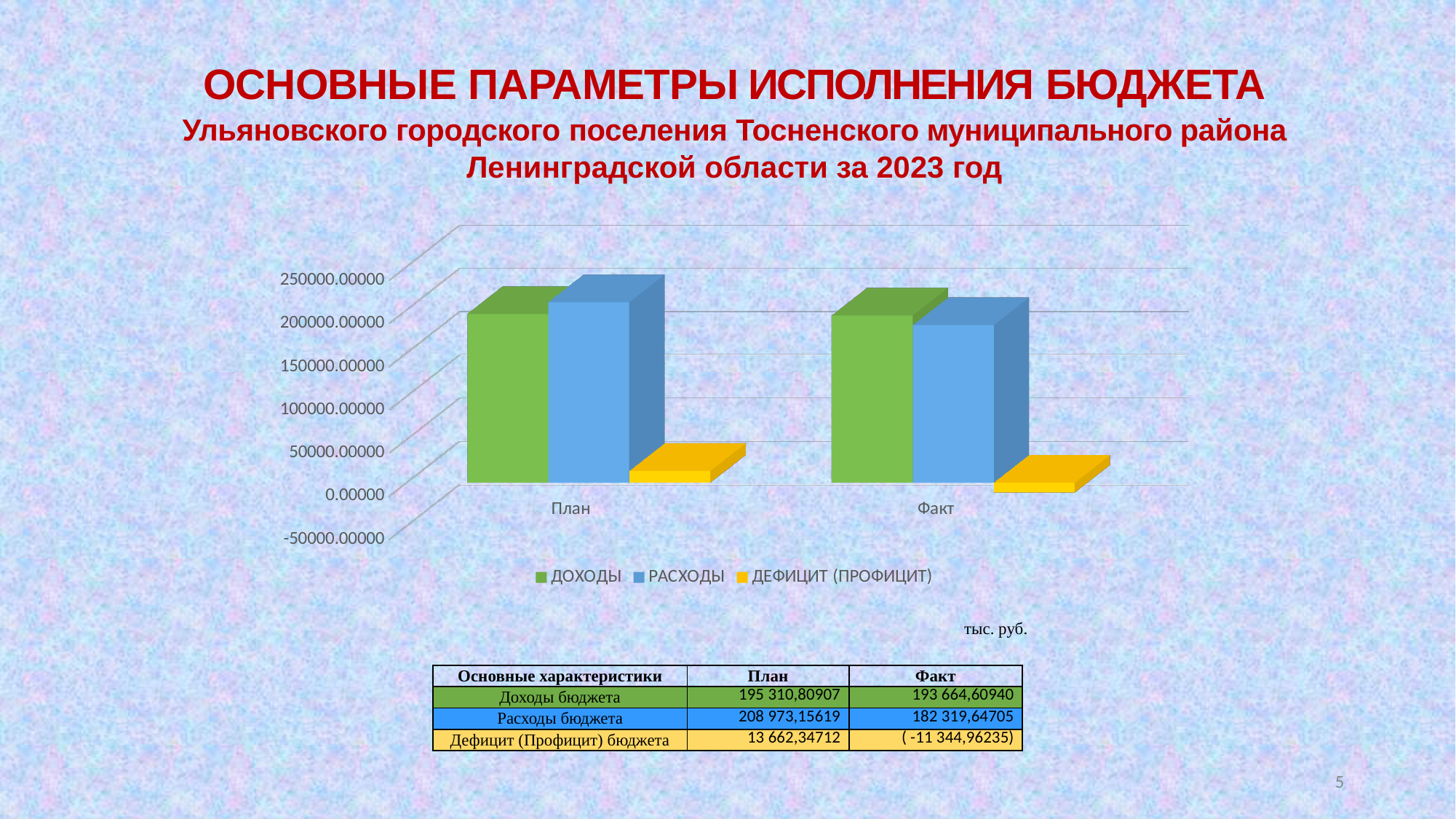
What kind of chart is shown on the slide? bar chart Which series is shown in green in the chart? ДОХОДЫ In the Факт category, which is larger: ДОХОДЫ or РАСХОДЫ? ДОХОДЫ How many series does the chart legend list? 3 In the План category, which is larger: ДОХОДЫ or РАСХОДЫ? РАСХОДЫ Is the value for РАСХОДЫ in the План category greater or less than 200000.00000? greater Is the value for РАСХОДЫ in the Факт category greater or less than 200000.00000? less Is the value for ДЕФИЦИТ (ПРОФИЦИТ) in the Факт category greater or less than 0.00000? less Which series is shown in yellow in the chart? ДЕФИЦИТ (ПРОФИЦИТ) Which bar in the chart is the tallest? РАСХОДЫ in План How many categories are shown on the x axis of the chart? 2